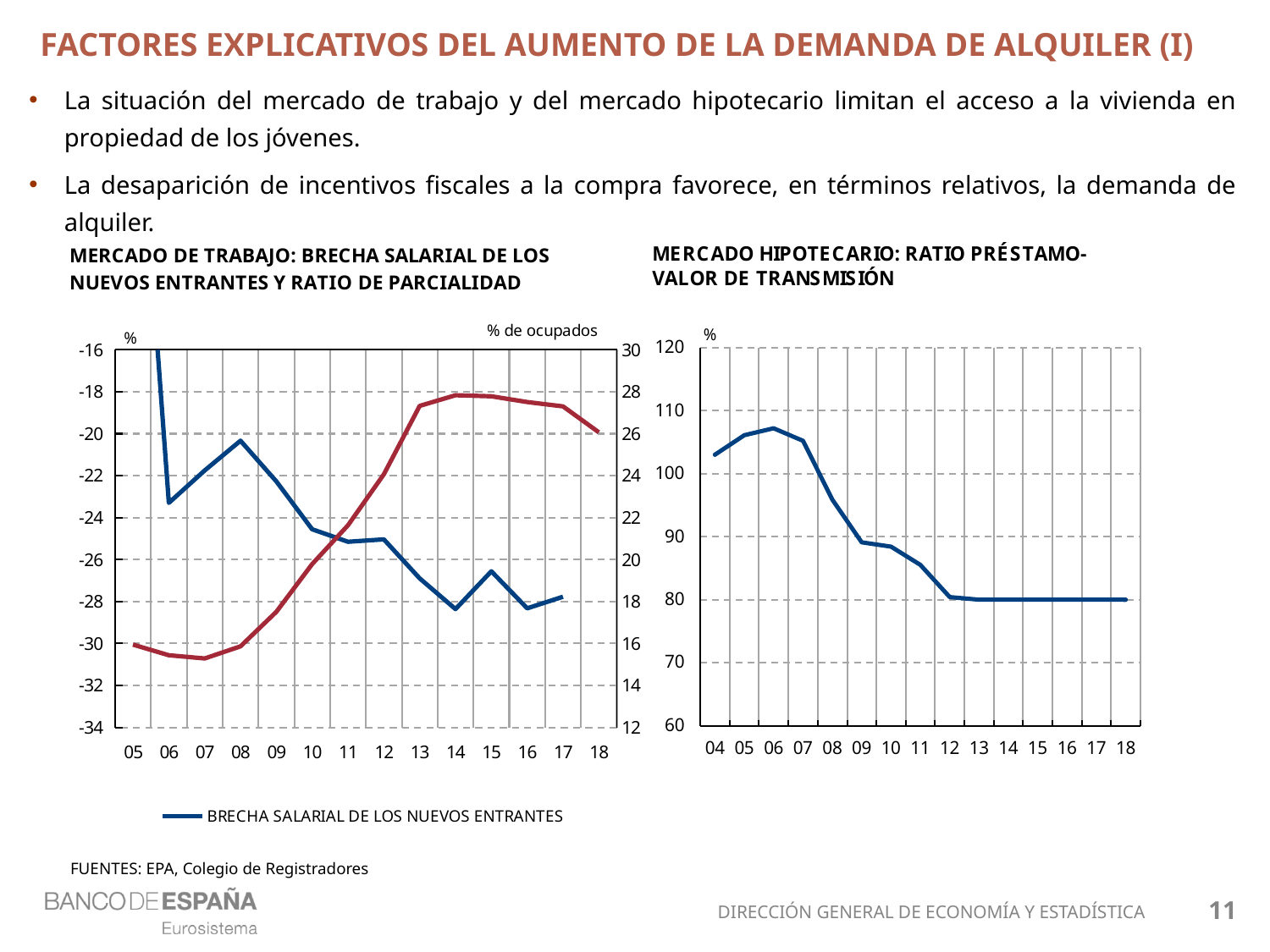
In the 'MERCADO HIPOTECARIO' chart, is the value for 06 greater or less than 100? greater In the 'MERCADO DE TRABAJO' chart, is the value of the red line (right axis) for 13 greater or less than 26? greater What kind of chart is the 'MERCADO DE TRABAJO' chart on the left? Line chart What kind of chart is the 'MERCADO HIPOTECARIO: RATIO PRÉSTAMO-VALOR DE TRANSMISIÓN' chart? Line chart In the 'MERCADO DE TRABAJO' chart, does the red line rise or fall from 07 to 14? rise In the 'MERCADO HIPOTECARIO' chart, how many years are shown on the x axis? 15 In the 'MERCADO HIPOTECARIO' chart, which year has the highest value? 06 In the 'MERCADO HIPOTECARIO' chart, is the value for 08 greater or less than 100? less In the 'MERCADO DE TRABAJO' chart, how many entries does the legend list? 1 In the 'MERCADO HIPOTECARIO' chart, does the value rise or fall overall from 06 to 13? fall